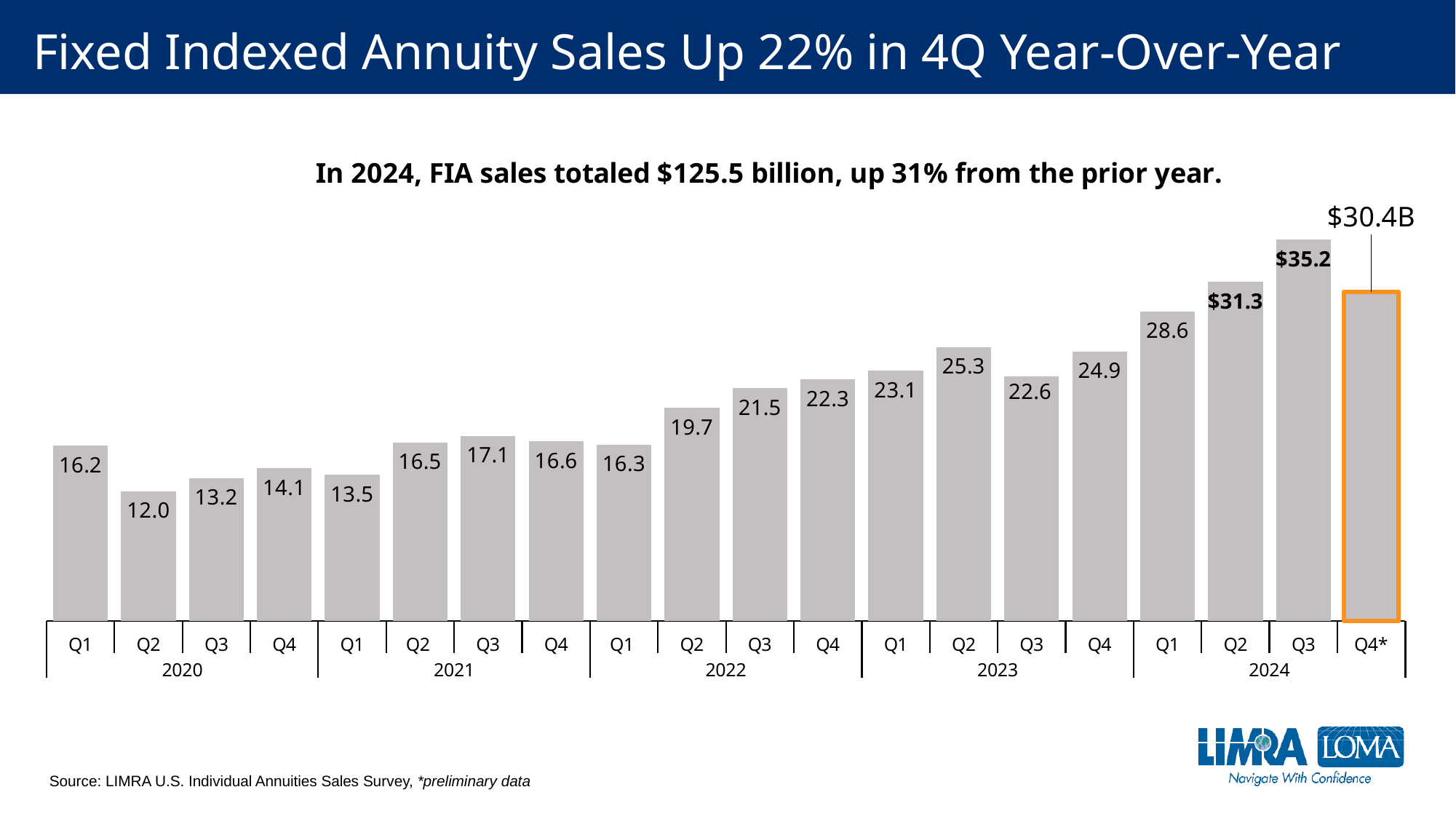
Which is larger, Q3 2023 or Q4 2023? Q4 2023 What is the value for Q4 2024? $30.4B How many bars are plotted on the chart? 20 Do the values generally rise or fall from Q1 2020 to Q3 2024? Rise What kind of chart is shown? Bar chart What is the value for Q3 2024? $35.2 Which quarter has the highest value? Q3 2024 What is the difference between Q3 2024 and Q2 2024? 3.9 Which quarter has the lowest value? Q2 2020 Which bar is outlined in orange? Q4 2024 What is the value for Q4 2022? 22.3 What is the value for Q2 2020? 12.0